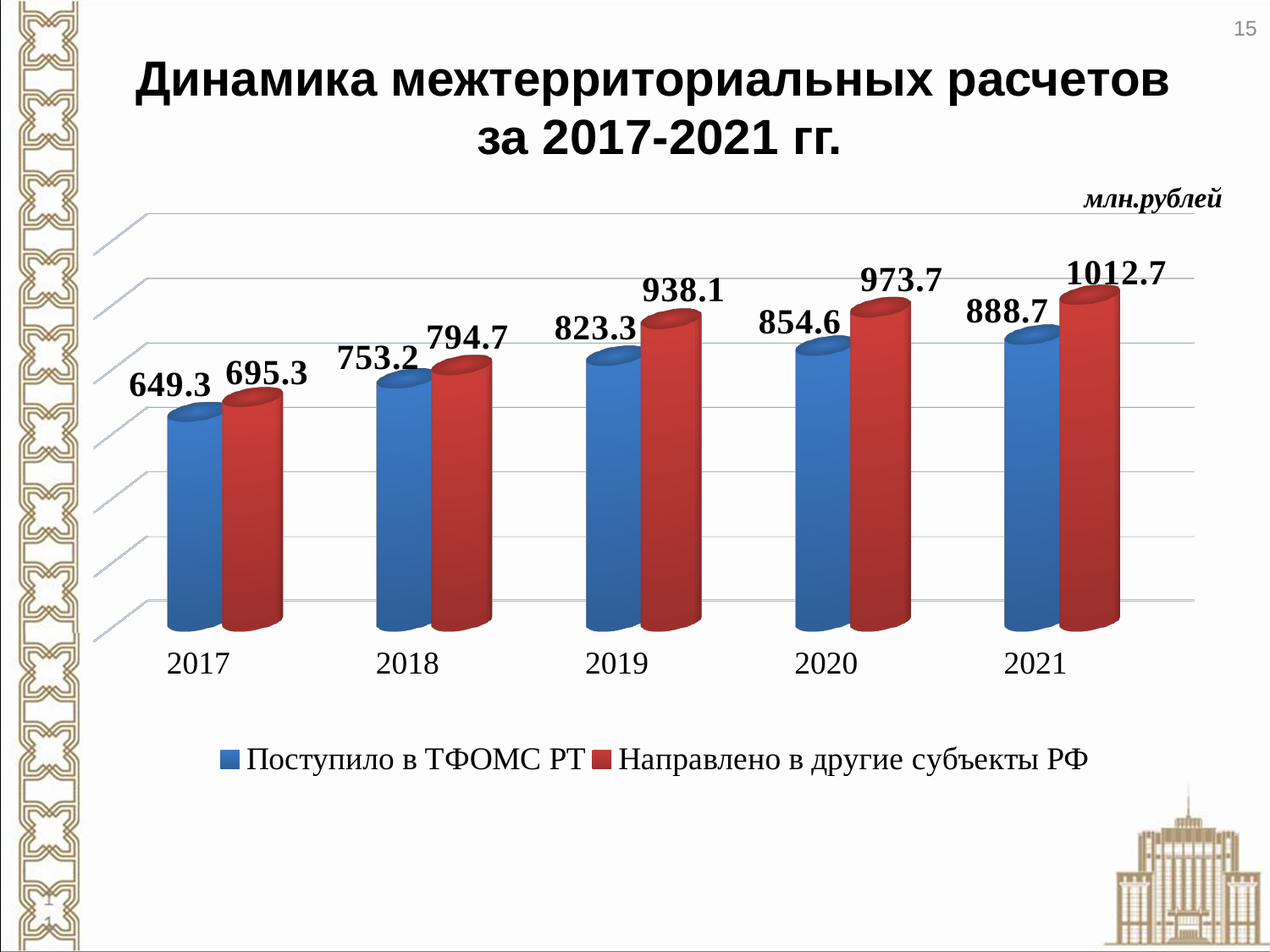
What is the value for "Поступило в ТФОМС РТ" in 2020? 854.6 What is the value for "Поступило в ТФОМС РТ" in 2017? 649.3 In which year is the value for "Направлено в другие субъекты РФ" highest? 2021 Do the values for "Поступило в ТФОМС РТ" rise or fall from 2017 to 2021? rise How many years are shown on the x axis? 5 What is the difference between "Направлено в другие субъекты РФ" and "Поступило в ТФОМС РТ" in 2021? 124.0 What kind of chart is shown on the slide? bar chart In which year is the value for "Поступило в ТФОМС РТ" lowest? 2017 What is the value for "Направлено в другие субъекты РФ" in 2021? 1012.7 What is the value for "Направлено в другие субъекты РФ" in 2019? 938.1 How many series does the legend list? 2 Which is larger in 2018: "Поступило в ТФОМС РТ" or "Направлено в другие субъекты РФ"? Направлено в другие субъекты РФ